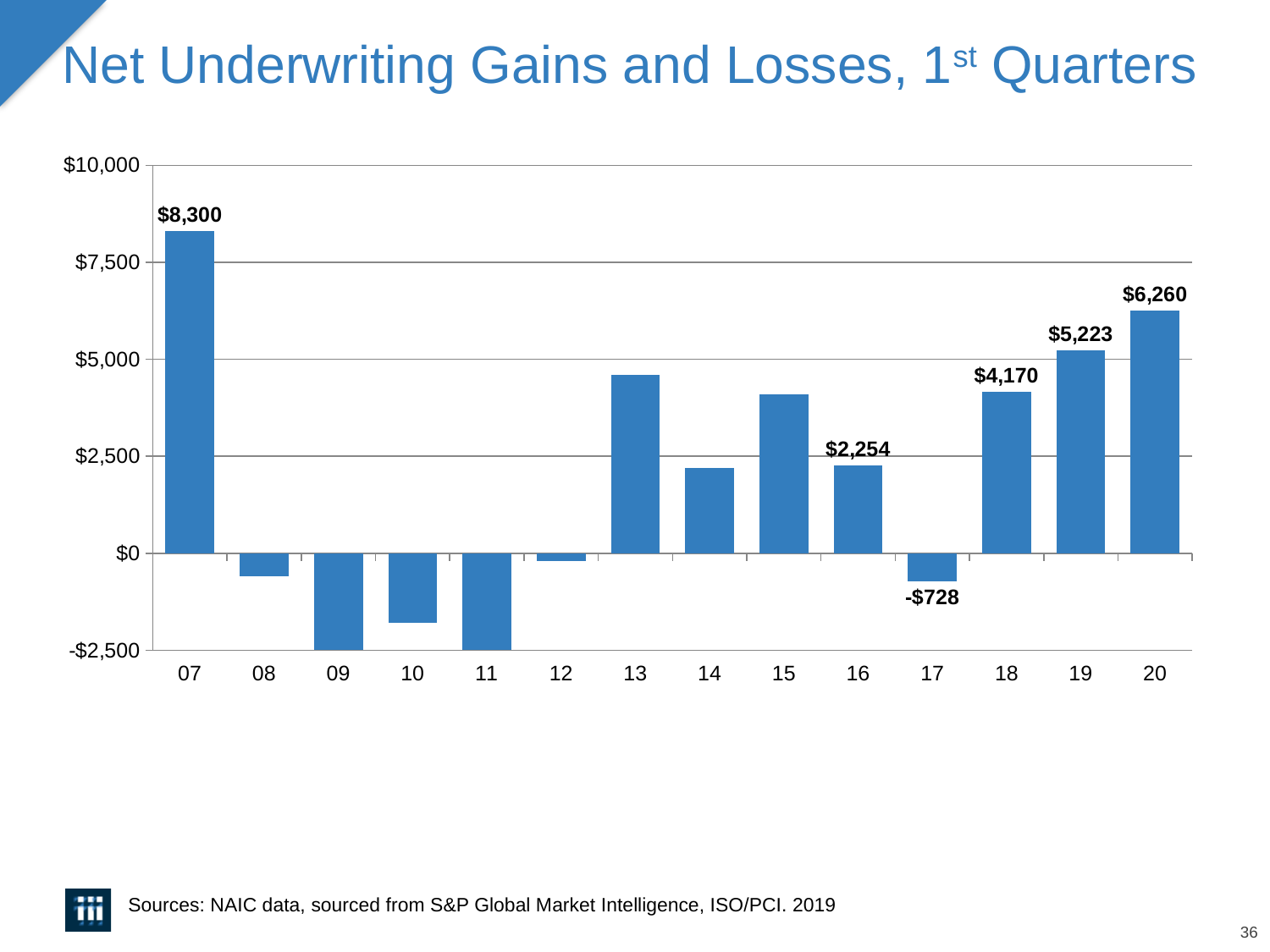
What kind of chart is shown on the slide? bar chart What is the value shown for 20? $6,260 What is the value shown for 18? $4,170 What is the net underwriting gain for the 1st quarter of 07? $8,300 What is the difference between the values for 19 and 18? $1,053 How many years are shown on the x axis? 14 Which is larger, the value for 18 or the value for 16? 18 Is the value for 10 greater or less than $0? less Which year has the highest net underwriting gain? 07 What is the value shown for 17? -$728 What is the difference between the values for 20 and 19? $1,037 Is the value for 13 greater or less than $2,500? greater